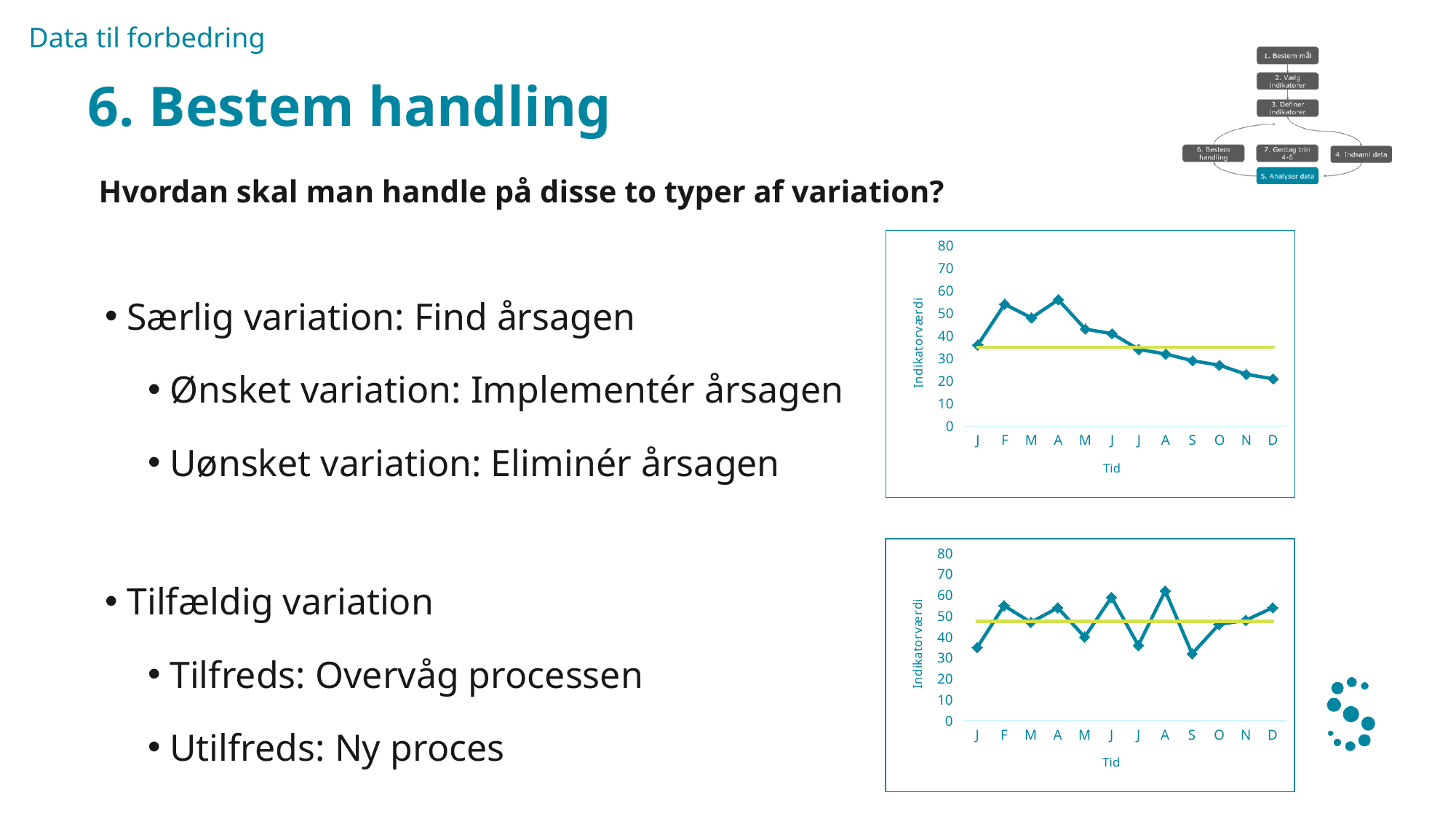
What kind of chart is the bottom chart on the slide? line chart In the bottom chart, which is larger, the value for F or the value for M (March)? F How many data points are plotted on the top chart? 12 In the top chart, is the value for A (April) greater or less than 50? greater In the top chart, is the value for D greater or less than 30? less In the top chart, do the values generally rise or fall from J (July) to D? fall In the bottom chart, which month has the highest value? A (August) In the top chart, which month has the lowest value? D What kind of chart is the top chart on the slide? line chart How many data points are plotted on the bottom chart? 12 What is the label on the vertical axis of the top chart? Indikatorværdi In the bottom chart, is the value for S greater or less than 40? less